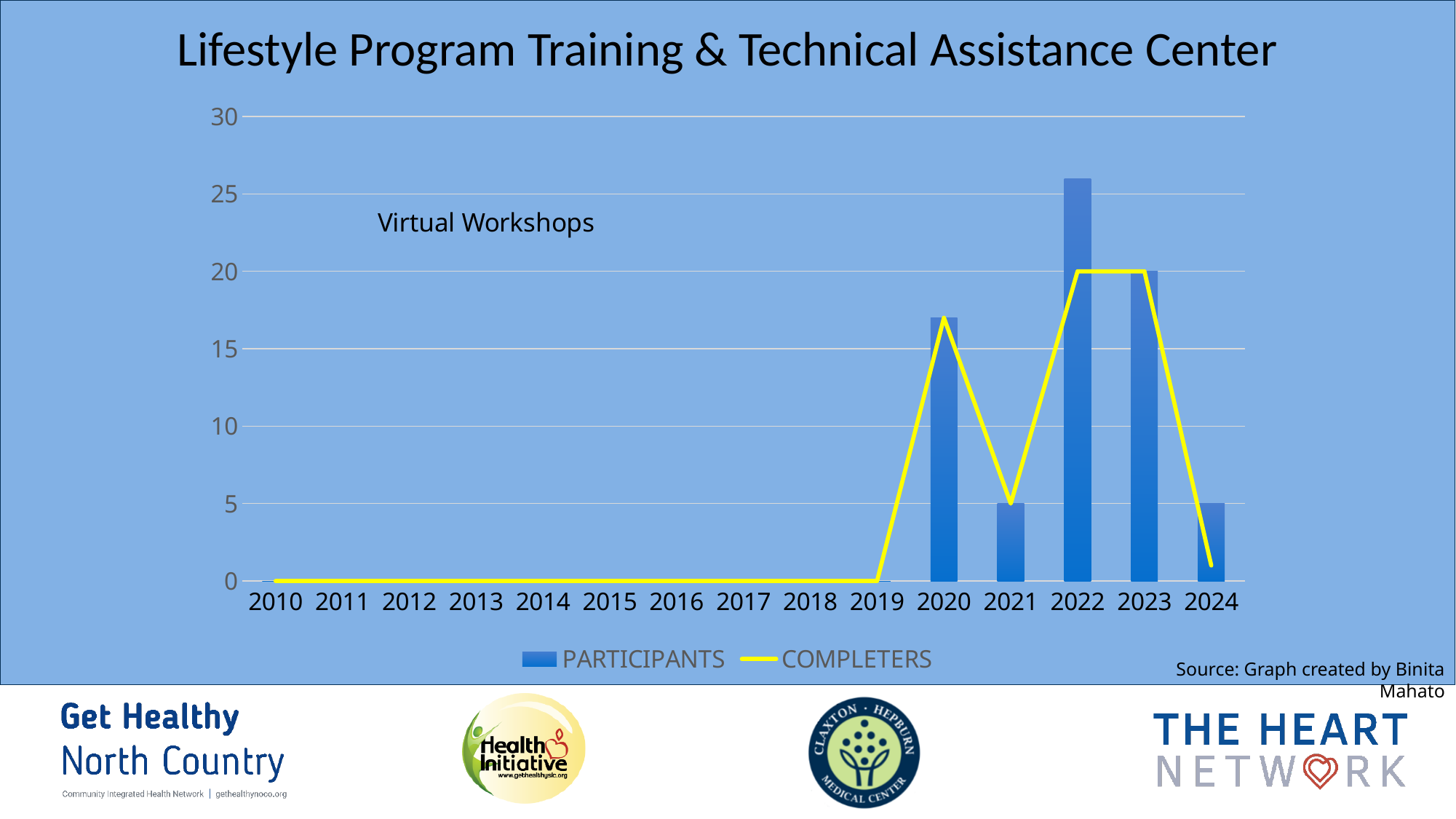
What is the PARTICIPANTS value for 2023? 20 What is the PARTICIPANTS value for 2021? 5 How many series does the legend list? 2 What is the COMPLETERS value for 2022? 20 Is the PARTICIPANTS value for 2022 greater or less than 25? greater What are the two legend entries of the chart? PARTICIPANTS and COMPLETERS Which is larger, the PARTICIPANTS value for 2022 or for 2023? 2022 In which year is the PARTICIPANTS bar highest? 2022 What kind of chart is shown on the slide? A combination bar and line chart How many years are shown on the x axis? 15 Is the COMPLETERS value for 2024 greater or less than 5? less What is the difference between the PARTICIPANTS values for 2023 and 2021? 15